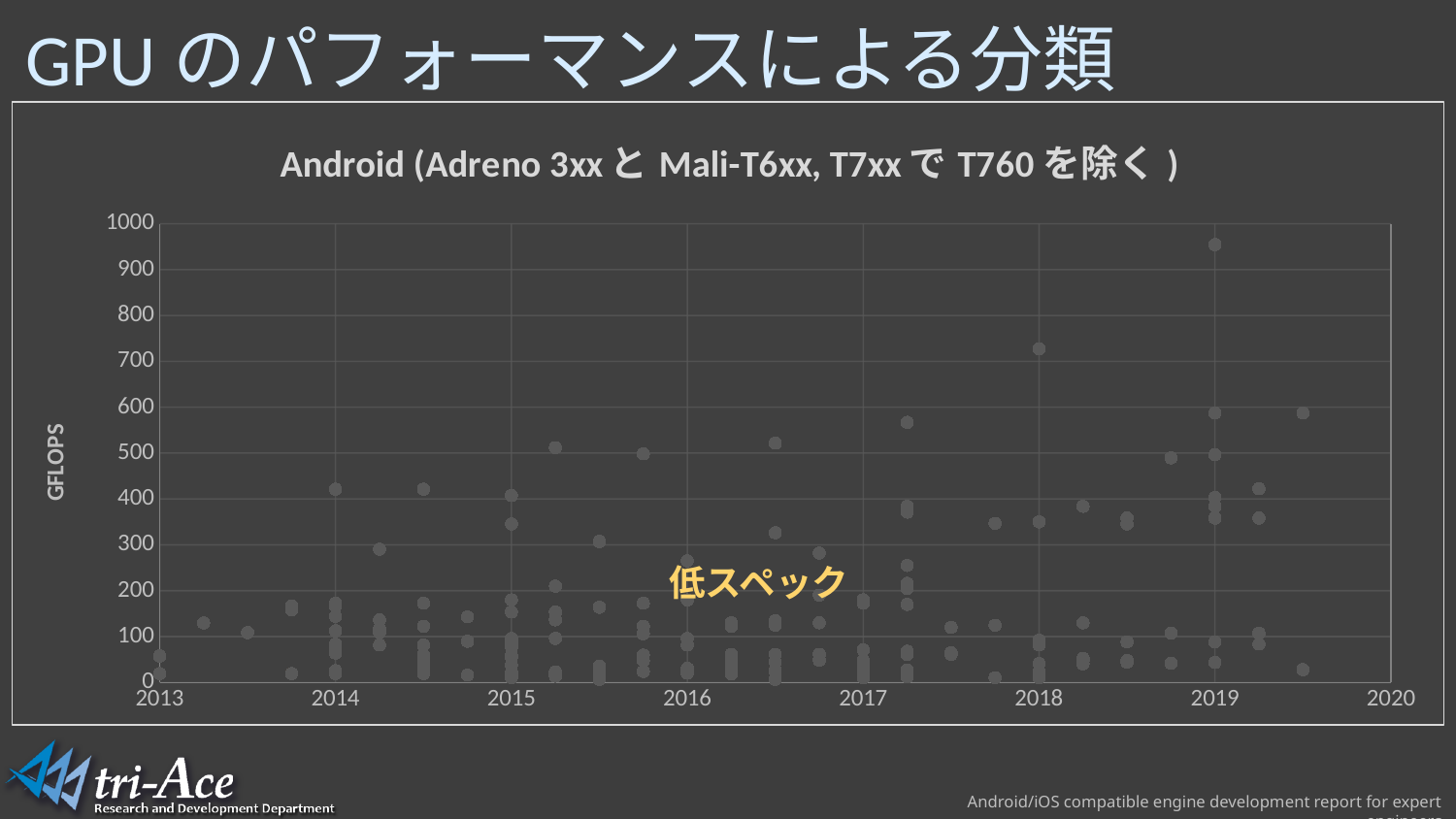
Which year on the x axis has the highest plotted point: 2018 or 2019? 2019 Is the highest point plotted near 2018 greater or less than 700 GFLOPS? greater Is the highest point plotted near 2015 greater or less than 600 GFLOPS? less What is the label on the vertical axis of the chart? GFLOPS Is the highest plotted point on the chart greater or less than 1000 GFLOPS? less Do the highest GFLOPS values plotted generally rise or fall from 2013 to 2019? rise What is the maximum value shown on the vertical axis? 1000 What is the last year labelled on the horizontal axis? 2020 What kind of chart is shown on the slide? scatter chart What is the title of the chart? Android (Adreno 3xx と Mali-T6xx, T7xx で T760 を除く )